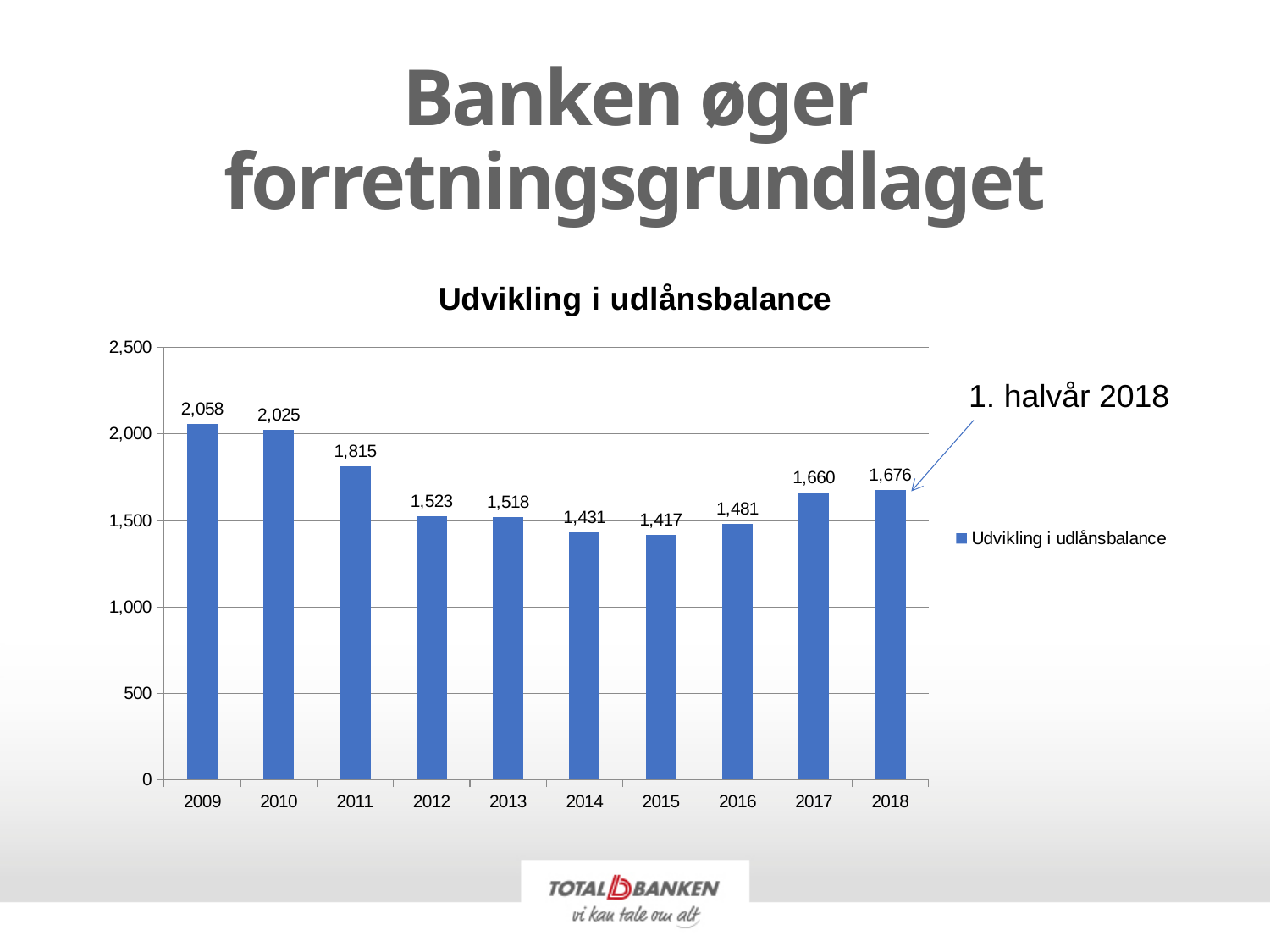
How many series does the legend list? 1 What is the difference between the values for 2009 and 2018? 382 What is the value for 2009? 2,058 Which year has the lowest value? 2015 What is the difference between the values for 2017 and 2016? 179 Which is larger, the value for 2011 or the value for 2012? 2011 What is the value for 2018? 1,676 What is the title of the chart? Udvikling i udlånsbalance What kind of chart is shown? bar chart What is the value for 2015? 1,417 How many years are shown on the x axis? 10 Which year has the highest value? 2009